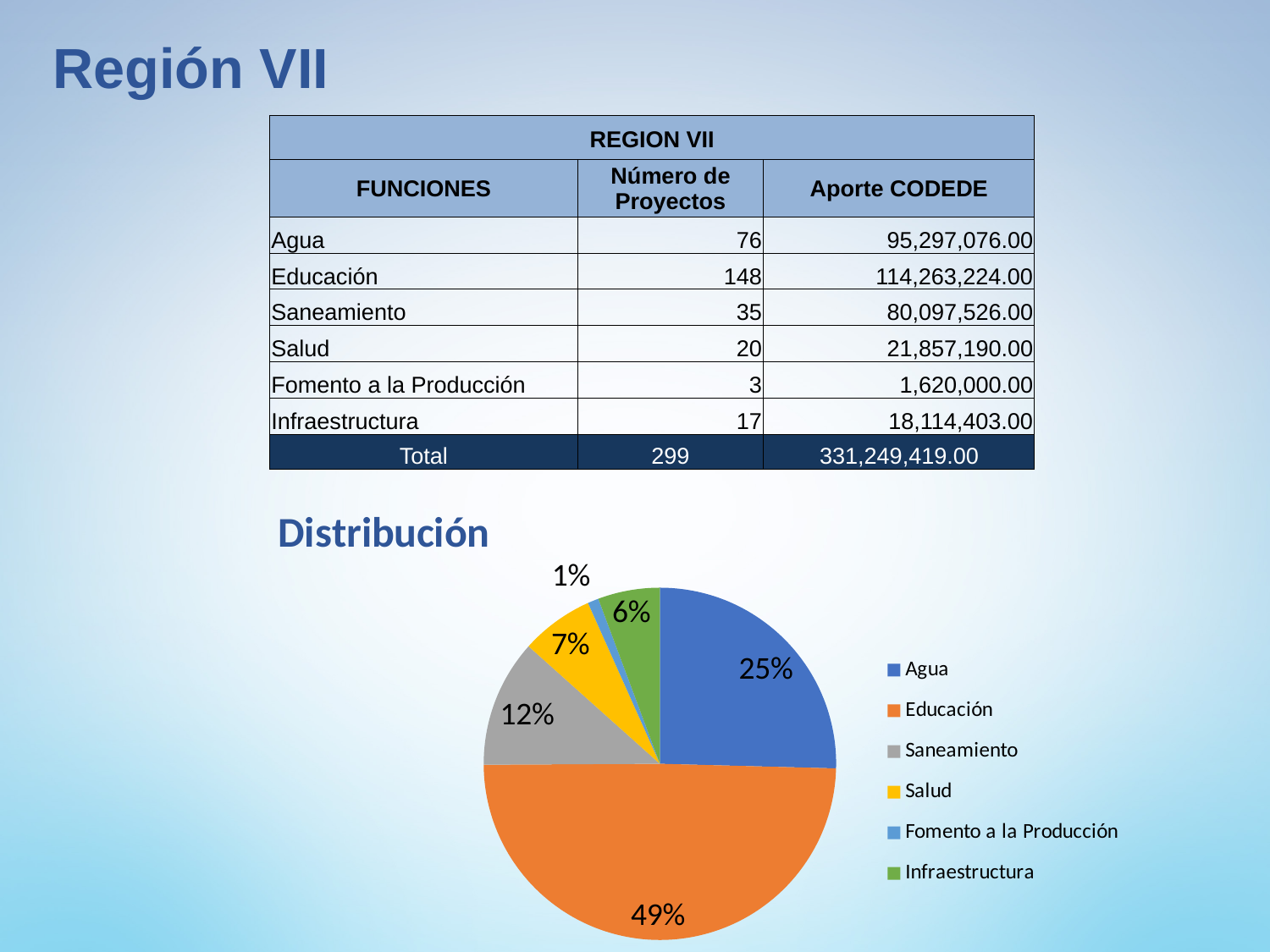
In the "Distribución" pie chart, what share does Fomento a la Producción have? 1% How many categories does the legend of the "Distribución" pie chart list? 6 Which category has the smallest slice in the "Distribución" pie chart? Fomento a la Producción In the "Distribución" pie chart, what share does Agua have? 25% In the "Distribución" pie chart, what share does Educación have? 49% In the "Distribución" pie chart, how many percentage points larger is the Educación slice than the Agua slice? 24 What kind of chart is shown under the heading "Distribución"? pie chart Which category has the largest slice in the "Distribución" pie chart? Educación In the "Distribución" pie chart, which slice is larger, Saneamiento or Salud? Saneamiento